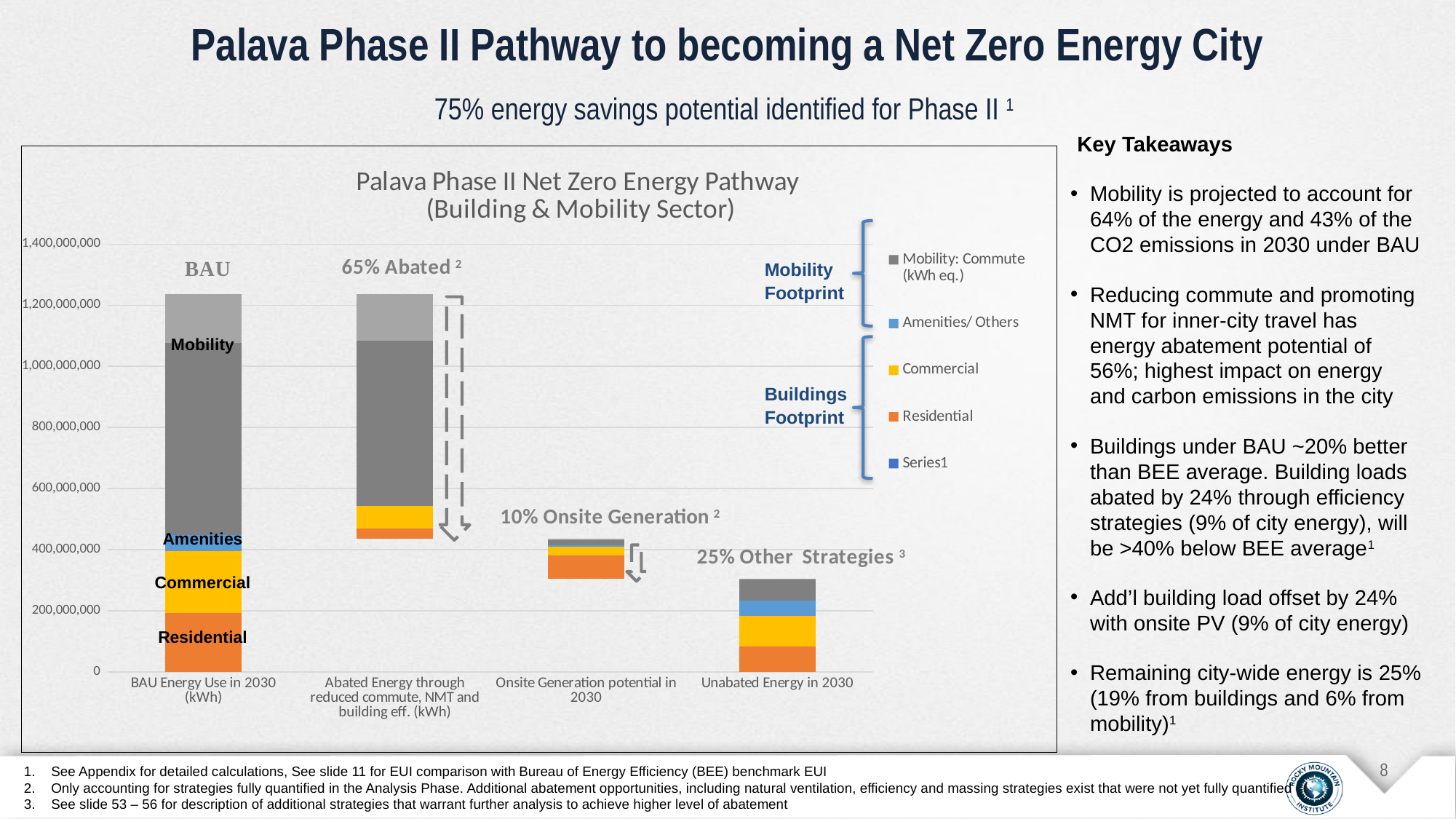
What percentage label is shown for the 'Unabated Energy in 2030' bar? 25% Other Strategies What percentage is labelled above the 'Abated Energy through reduced commute, NMT and building eff. (kWh)' bar? 65% Abated Is the top of the 'Unabated Energy in 2030' bar greater or less than 400,000,000? less Which bar reaches a higher value: 'BAU Energy Use in 2030 (kWh)' or 'Unabated Energy in 2030'? BAU Energy Use in 2030 (kWh) How many categories are shown along the x axis of the chart? 4 What is the title of the chart? Palava Phase II Net Zero Energy Pathway (Building & Mobility Sector) Is the total value of the 'BAU Energy Use in 2030 (kWh)' bar greater or less than 1,000,000,000? greater Which legend entry is shown in orange? Residential What percentage label is shown for the 'Onsite Generation potential in 2030' bar? 10% Onsite Generation How many series does the chart legend list? 5 Is the top of the 'Onsite Generation potential in 2030' bar greater or less than 600,000,000? less What type of chart is shown on the slide? Stacked bar chart